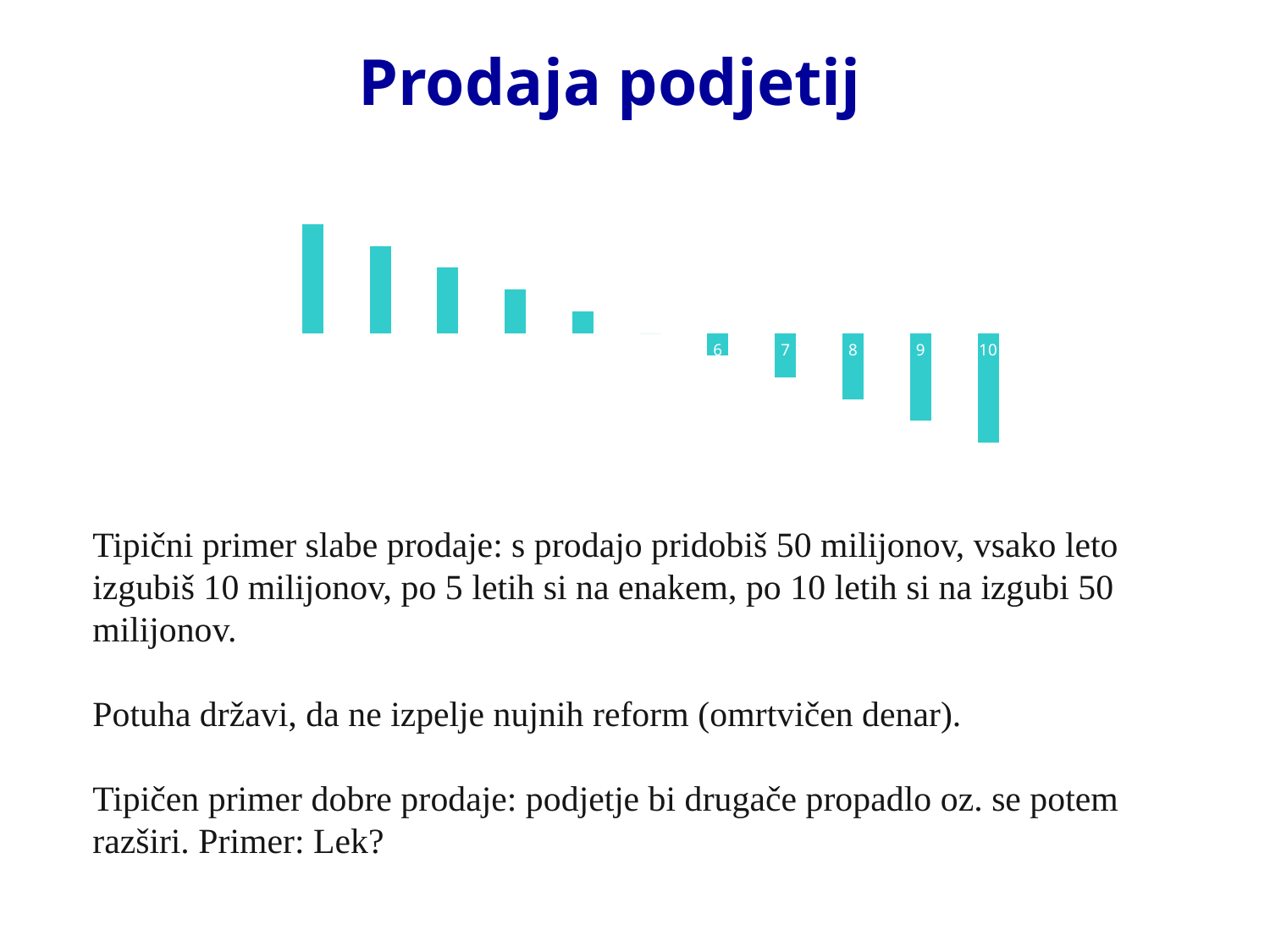
Which is larger, the value for category 7 or the value for category 9? 7 What kind of chart is shown on the slide? bar chart Which is larger, the value for category 8 or the value for category 9? 8 What is the title of the slide containing the chart? Prodaja podjetij Which is larger, the value for category 6 or the value for category 10? 6 Which category has the lowest value in the chart? 10 Do the bar values rise or fall moving from left to right along the x axis? fall Are the bars for categories 6 through 10 above or below the horizontal axis? below